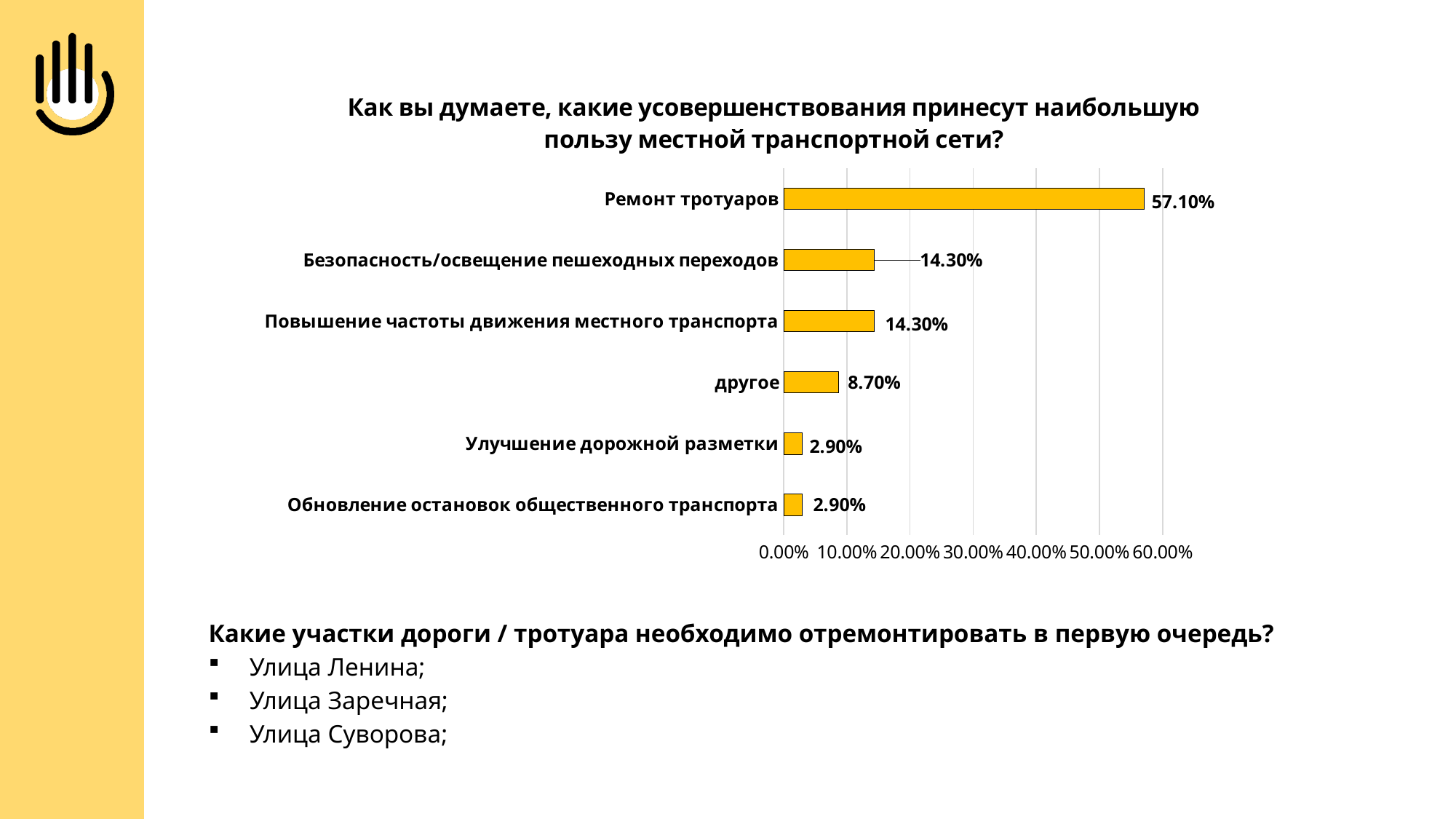
How many categories are shown in the chart? 6 What is the difference between the values for Безопасность/освещение пешеходных переходов and Обновление остановок общественного транспорта? 11.40% What is the difference between the values for Ремонт тротуаров and другое? 48.40% What is the value for Повышение частоты движения местного транспорта? 14.30% Which is larger, the value for другое or the value for Улучшение дорожной разметки? другое What is the title of the chart? Как вы думаете, какие усовершенствования принесут наибольшую пользу местной транспортной сети? What is the value for Ремонт тротуаров? 57.10% What is the value for другое? 8.70% Is the value for Ремонт тротуаров greater or less than 50.00%? greater What kind of chart is shown on the slide? bar chart What is the value for Улучшение дорожной разметки? 2.90% Which category has the highest value? Ремонт тротуаров